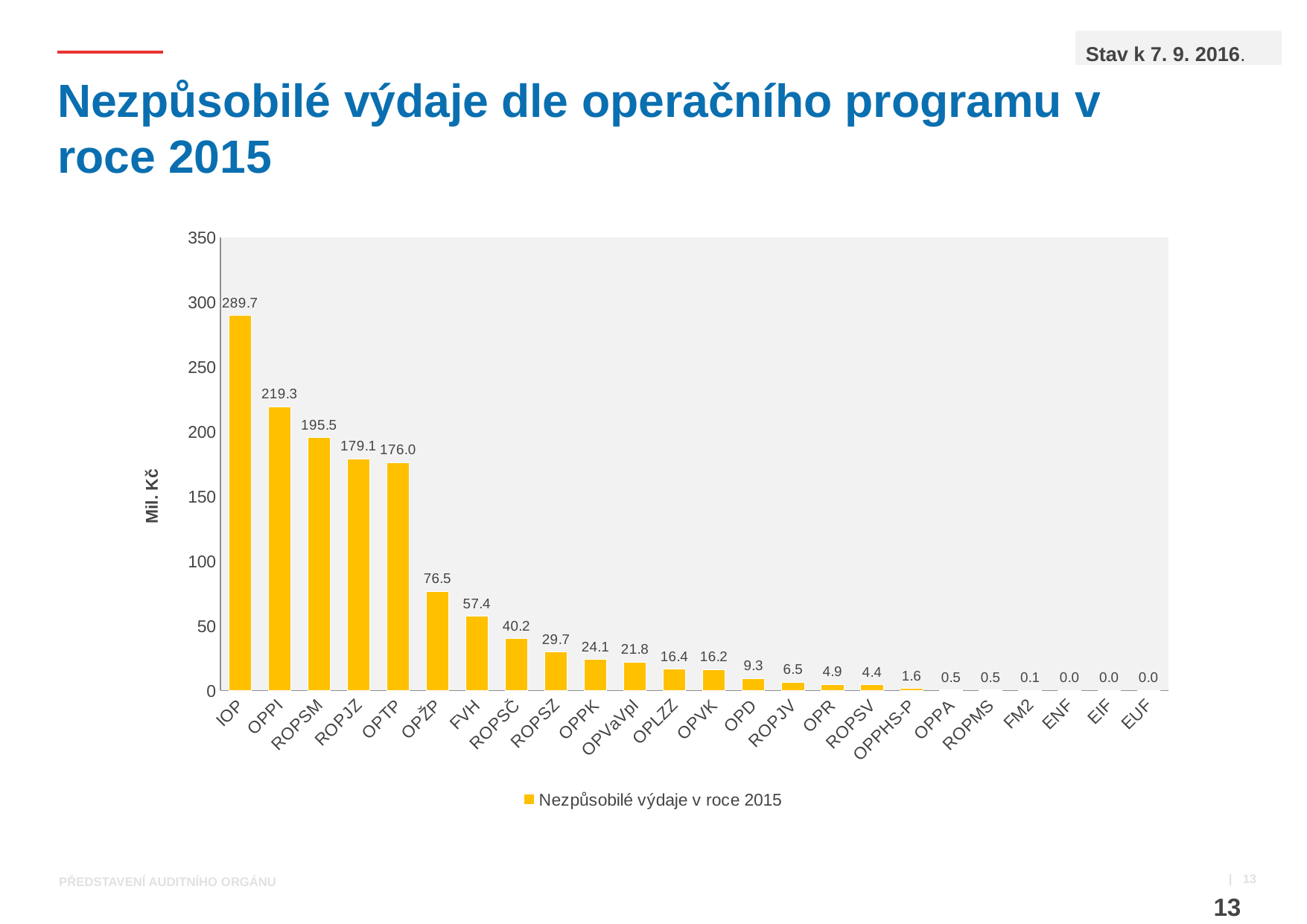
What is the value for IOP? 289.7 What is the difference between the values for OPPI and ROPSM? 23.8 Is the value for OPPI greater or less than 200? greater What is the unit shown on the y axis label? Mil. Kč How many operational programmes are shown on the x axis? 24 What is the value for OPŽP? 76.5 Which is larger, the value for FVH or the value for ROPSČ? FVH What is the difference between the values for ROPJZ and OPTP? 3.1 What is the value for ROPSV? 4.4 What kind of chart is shown on the slide? Bar chart Which operational programme has the highest value? IOP What is the value for OPVK? 16.2